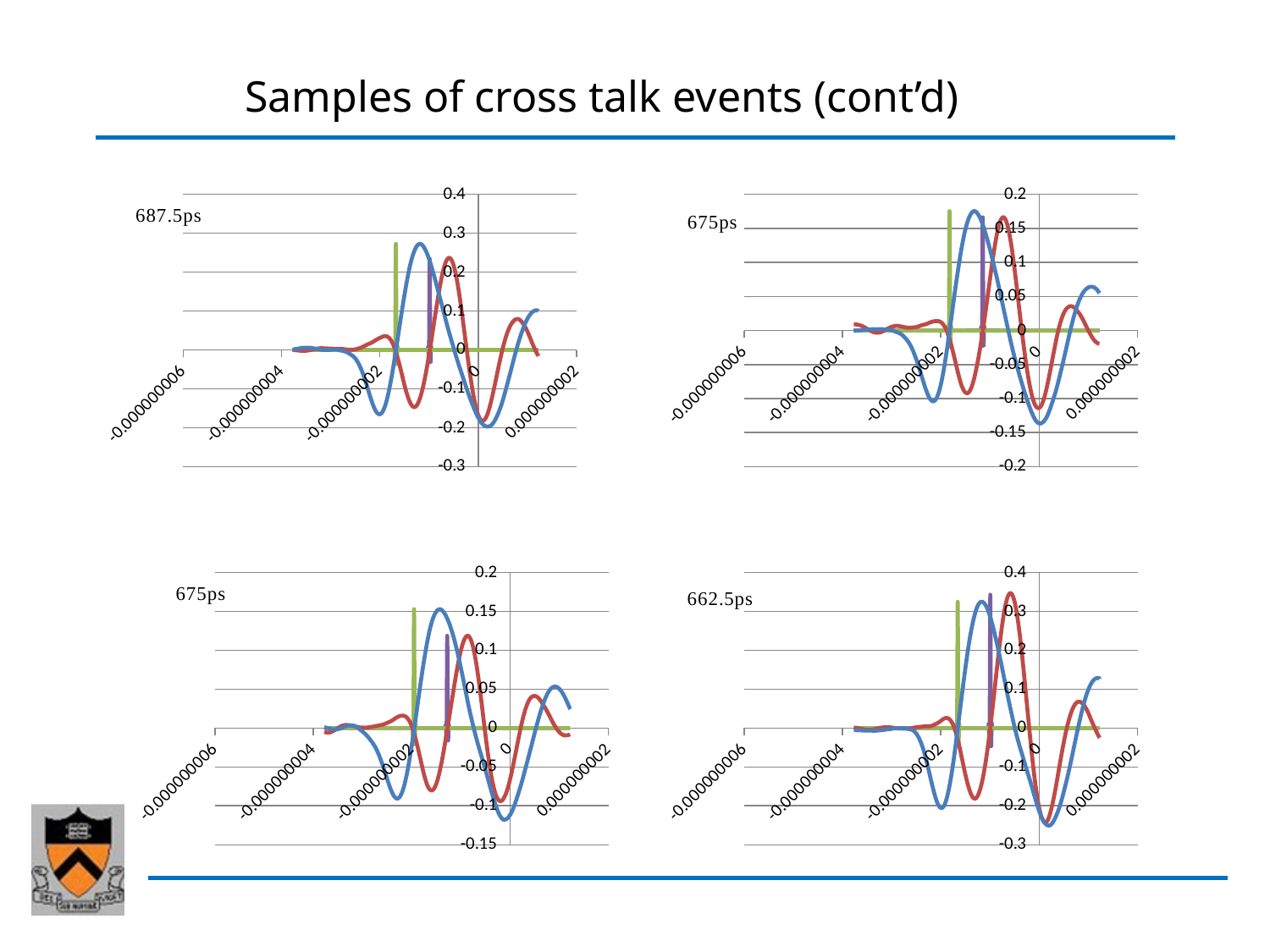
How many charts are shown on the slide? 4 What is the time label printed on the top-left chart? 687.5ps In the bottom-right chart (662.5ps), is the peak of the blue line greater or less than 0.3? greater In the top-left chart (687.5ps), is the peak of the blue line greater or less than 0.3? less In the top-right chart (675ps), what is the lowest value shown on the vertical axis? -0.2 What is the time label printed on the bottom-right chart? 662.5ps In the top-left chart (687.5ps), what is the highest value shown on the vertical axis? 0.4 In the bottom-left chart (675ps), is the peak of the red line greater or less than 0.1? greater What kind of chart is the top-left chart labelled 687.5ps? Line chart In the bottom-left chart (675ps), what is the lowest value shown on the vertical axis? -0.15